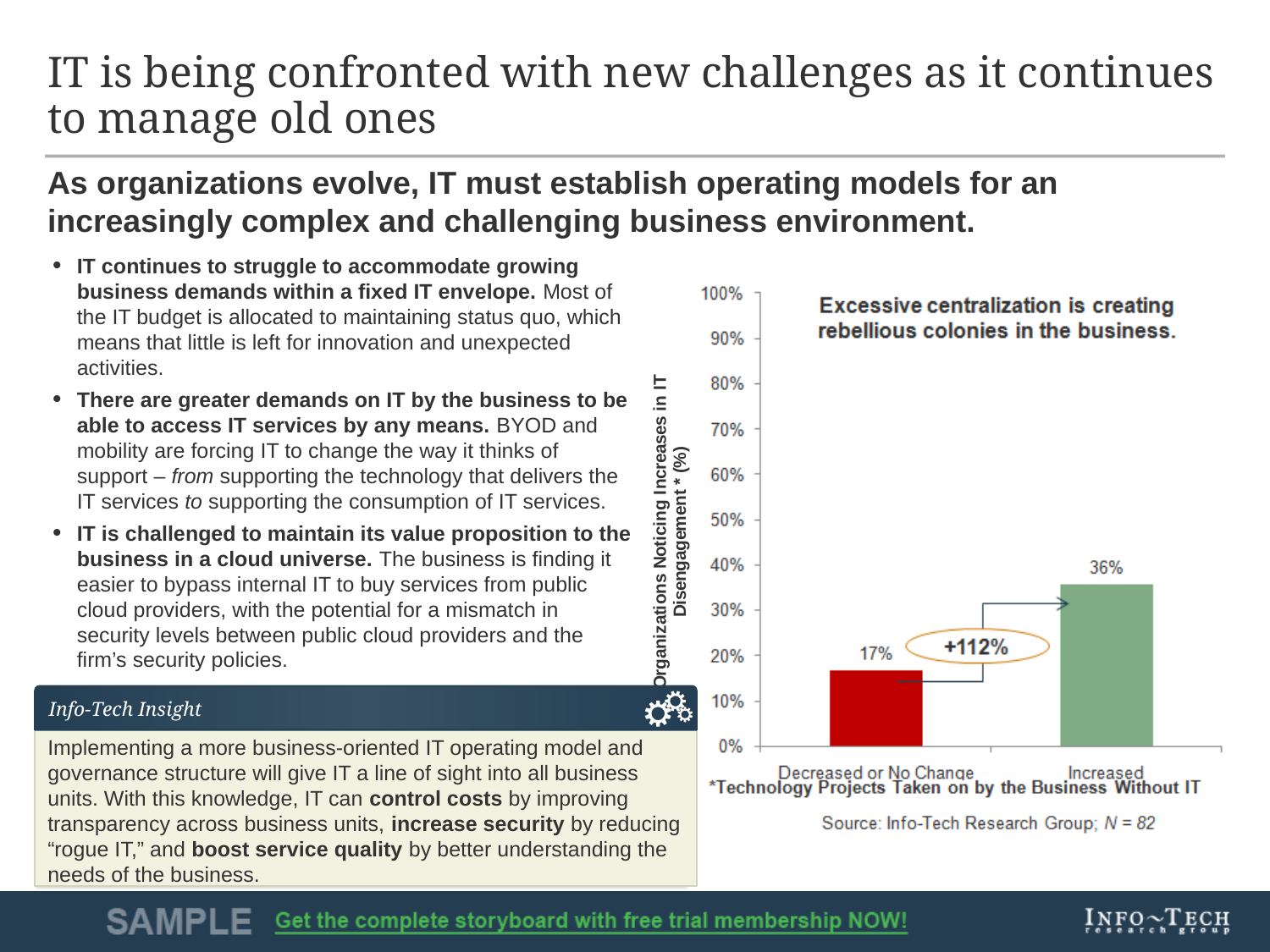
What is the value for "Decreased or No Change"? 17% Which is larger, the value for "Increased" or the value for "Decreased or No Change"? Increased What kind of chart is shown? Bar chart Which category has the highest value? Increased How many categories are shown on the x axis? 2 Is the value for "Decreased or No Change" greater or less than 20%? less What is the difference between the values for "Increased" and "Decreased or No Change"? 19% Is the value for "Increased" greater or less than 30%? greater Which category has the lowest value? Decreased or No Change What percentage increase is shown in the callout between the two bars? +112% What is the value for "Increased"? 36% What is the title of the chart? Excessive centralization is creating rebellious colonies in the business.